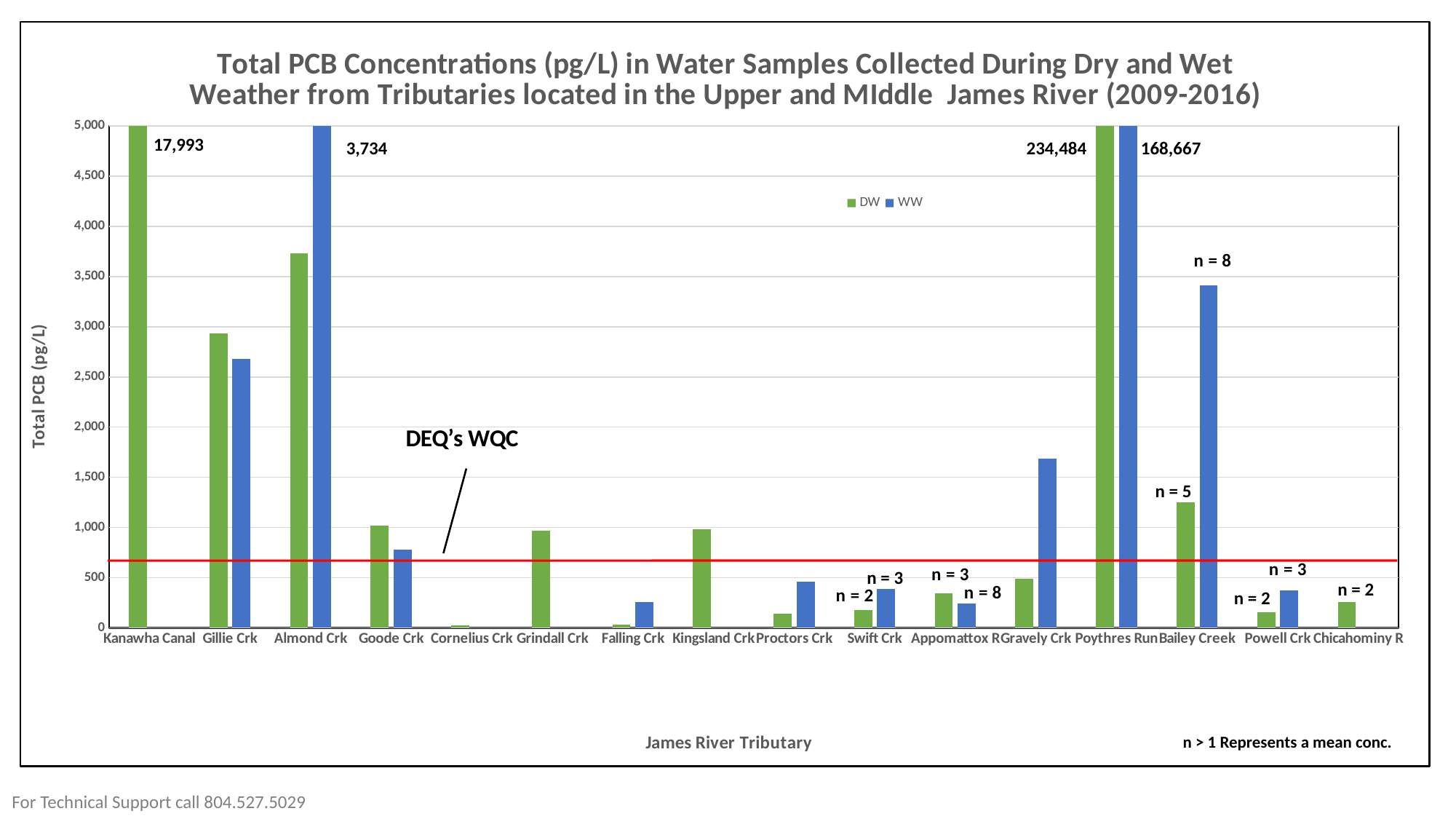
What is the DW value labelled for Kanawha Canal? 17,993 Is the DW value for Gillie Crk greater or less than 2,500? greater How many series does the legend list? 2 What is the WW value labelled for Poythres Run? 168,667 What kind of chart is shown on the slide? bar chart What is the DW value labelled for Poythres Run? 234,484 Is the WW value for Gravely Crk greater or less than 1,500? greater For Bailey Creek, which is larger, the DW value or the WW value? WW How many tributaries are shown along the x axis? 16 What does the red horizontal line represent? DEQ's WQC Which tributary has the highest DW value? Poythres Run What is the difference between the DW and WW values for Poythres Run? 65,817